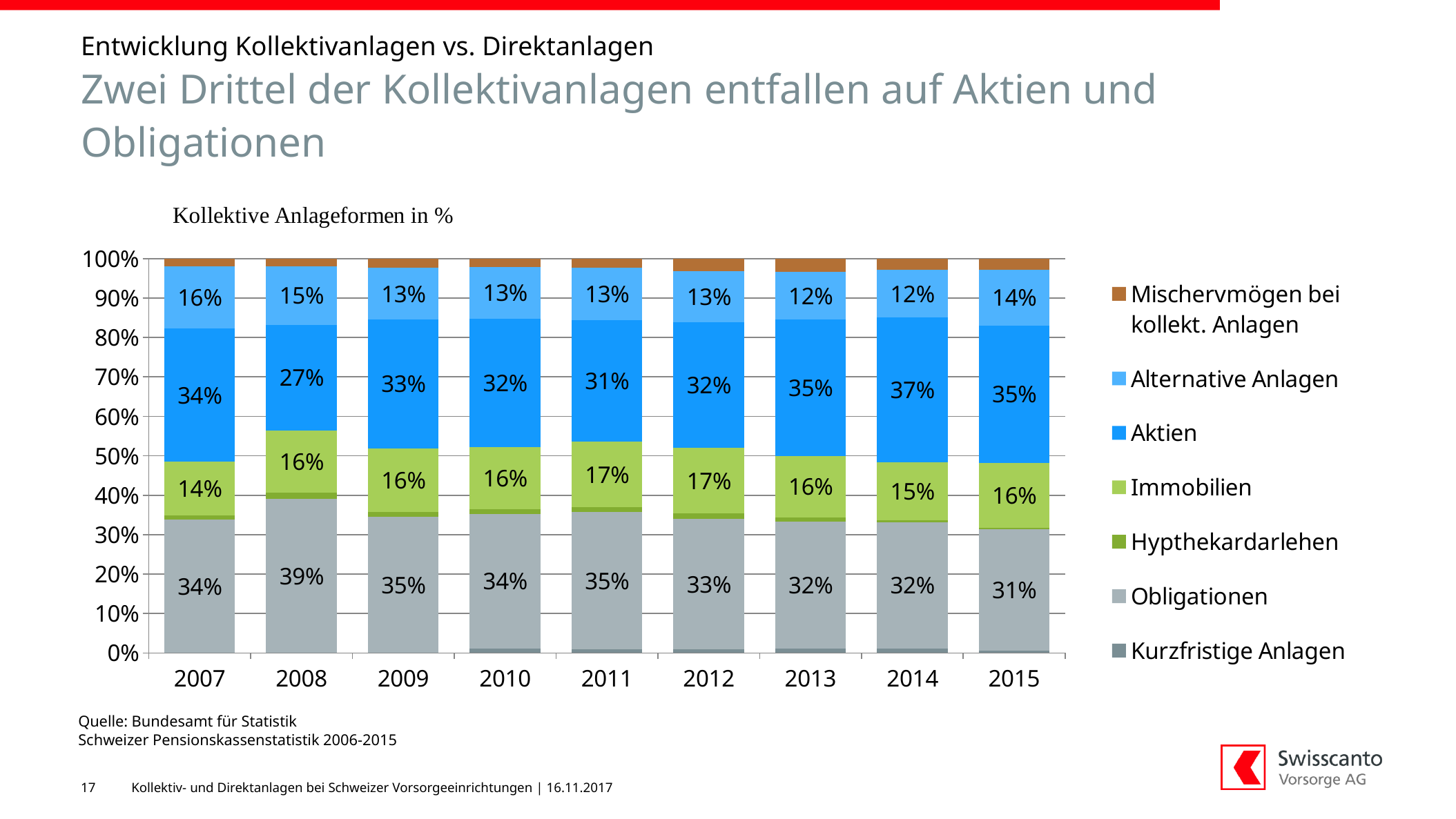
What is the value for Immobilien in 2011? 17% In which year is the Aktien share highest? 2014 What is the value for Obligationen in 2008? 39% What is the value for Aktien in 2014? 37% Does the Aktien share rise or fall from 2012 to 2014? Rise How many series does the legend list? 7 What kind of chart is shown on the slide? Stacked bar chart What is the value for Alternative Anlagen in 2007? 16% In which year is the Obligationen share lowest? 2015 How many years are shown on the x axis? 9 In 2015, which is larger: the Aktien share or the Obligationen share? Aktien What is the difference between the Aktien share in 2014 and in 2008? 10 percentage points